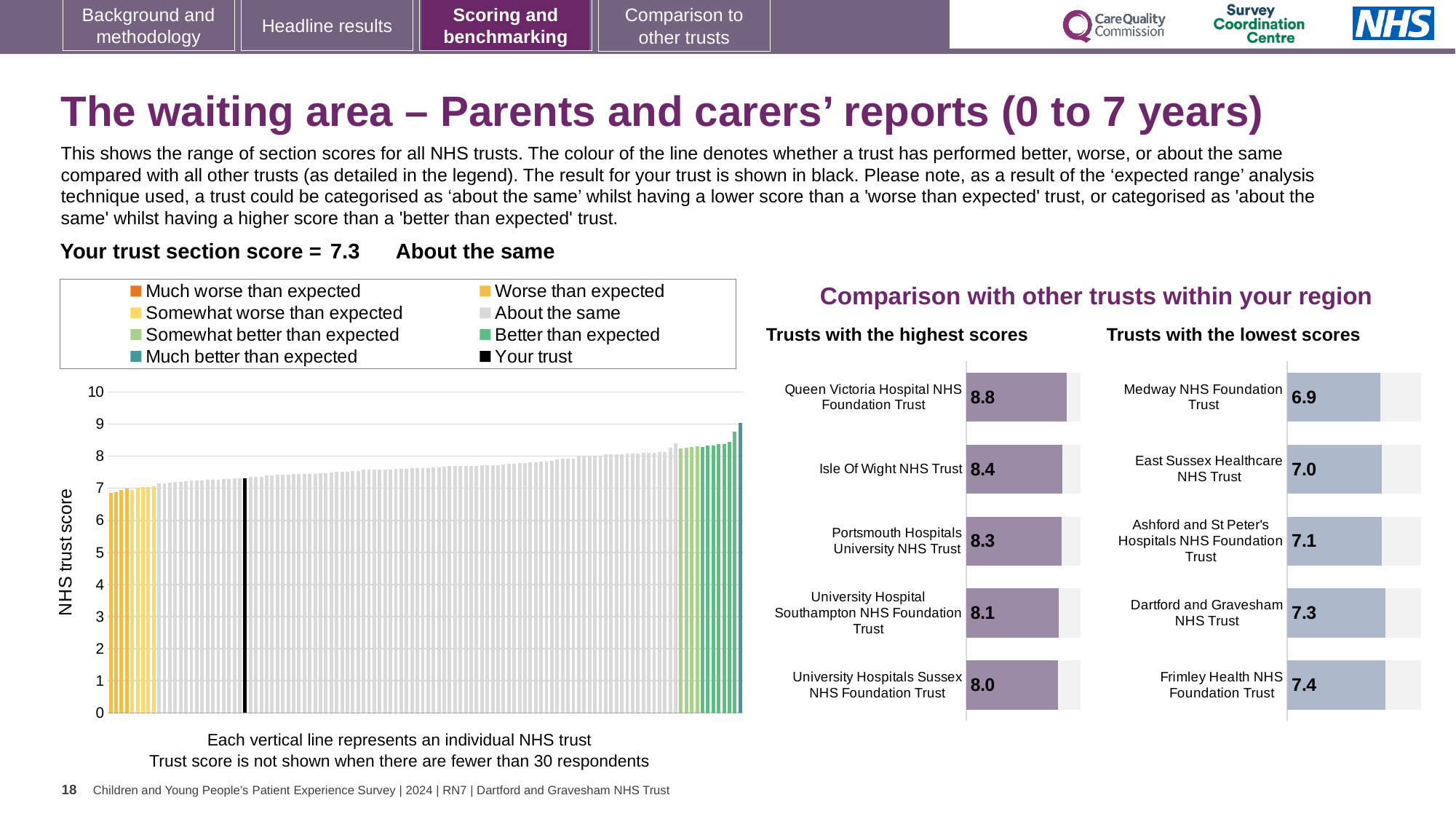
In the 'Trusts with the lowest scores' chart, which trust has the lowest score? Medway NHS Foundation Trust In the 'Trusts with the lowest scores' chart, which has the higher score: Dartford and Gravesham NHS Trust or Ashford and St Peter's Hospitals NHS Foundation Trust? Dartford and Gravesham NHS Trust In the large 'NHS trust score' chart, is the value for the black 'Your trust' bar greater or less than 8? less In the large 'NHS trust score' chart, do the trust scores rise or fall from left to right? rise In the 'Trusts with the lowest scores' chart, what is the score for Medway NHS Foundation Trust? 6.9 In the 'Trusts with the lowest scores' chart, what is the score for Frimley Health NHS Foundation Trust? 7.4 In the 'Trusts with the highest scores' chart, what is the score for Portsmouth Hospitals University NHS Trust? 8.3 In the 'Trusts with the highest scores' chart, what is the score for Queen Victoria Hospital NHS Foundation Trust? 8.8 In the 'Trusts with the highest scores' chart, which trust has the highest score? Queen Victoria Hospital NHS Foundation Trust In the 'Trusts with the highest scores' chart, what is the difference between the scores of Queen Victoria Hospital NHS Foundation Trust and University Hospitals Sussex NHS Foundation Trust? 0.8 How many trusts are shown in the 'Trusts with the lowest scores' chart? 5 How many entries does the legend of the large 'NHS trust score' chart list? 8